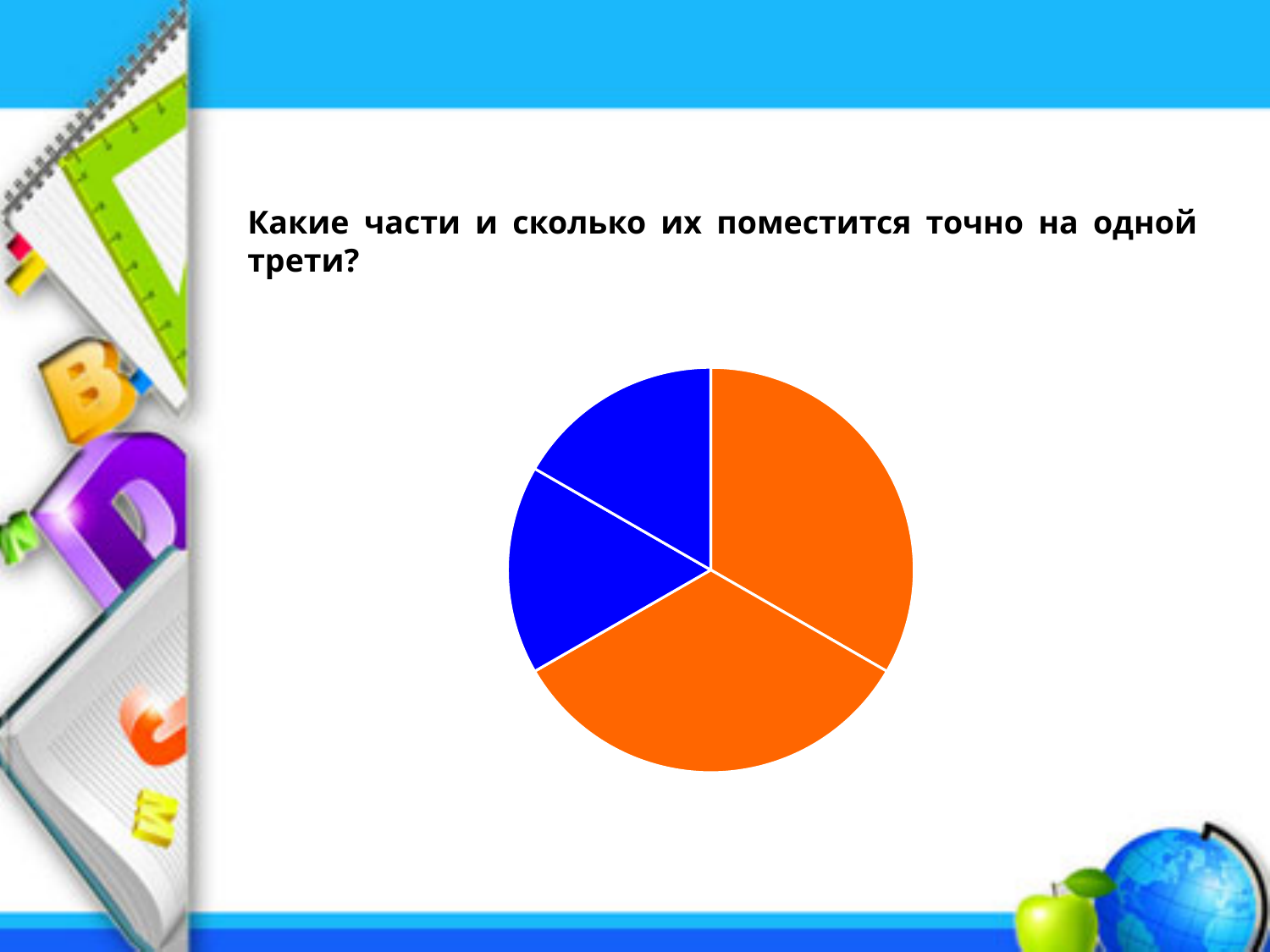
How many slices does the pie chart have? 4 What kind of chart is shown on the slide? pie chart How many different colours are used for the slices of the pie chart? 2 Which colour of slice is larger in the pie chart, orange or blue? orange How many slices of the pie chart are orange? 2 Which colour has the smallest slices in the pie chart? blue